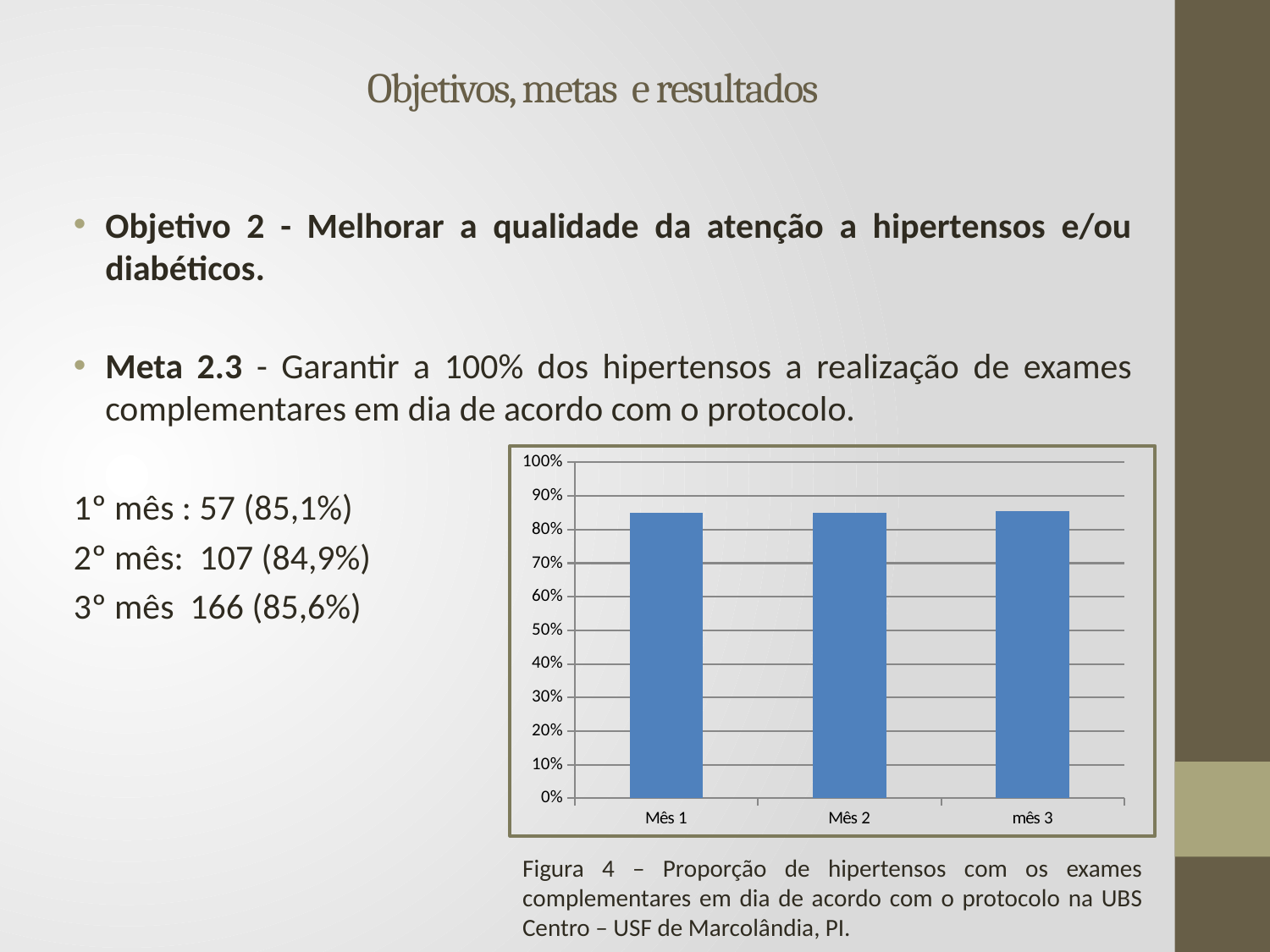
Is the value for Mês 1 greater or less than 80%? greater Is the value for Mês 2 greater or less than 90%? less Is the value for mês 3 greater or less than 80%? greater What kind of chart is shown on the slide? bar chart What is the highest value shown on the chart's vertical axis? 100% What colour are the bars in the chart? blue What are the category labels on the x axis of the chart? Mês 1, Mês 2, mês 3 How many bars (categories) does the chart show? 3